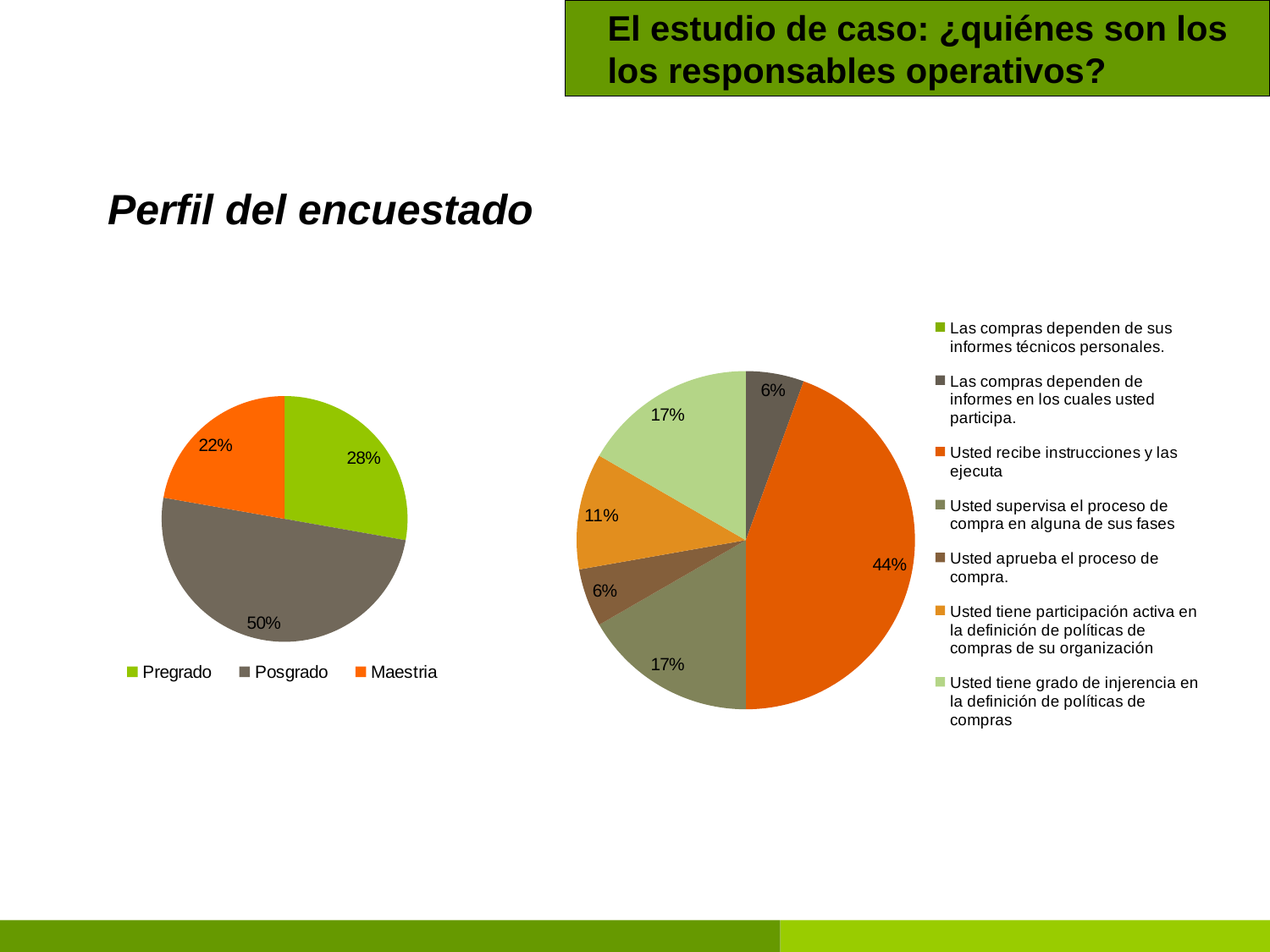
On the right pie chart, what share is labelled for 'Usted tiene participación activa en la definición de políticas de compras de su organización'? 11% On the left pie chart, what is the difference in percentage points between Posgrado and Pregrado? 22 On the left pie chart, which category has the smallest slice? Maestria On the left pie chart, which category has the largest slice? Posgrado How many entries does the legend of the right pie chart list? 7 On the left pie chart, which is larger, Pregrado or Maestria? Pregrado How many categories does the legend of the left pie chart list? 3 On the right pie chart, what share is labelled for 'Usted recibe instrucciones y las ejecuta'? 44% On the left pie chart, what share is labelled for Pregrado? 28% What kind of chart is the chart on the left of the slide? Pie chart On the left pie chart, what share is labelled for Maestria? 22% On the left pie chart, what share is labelled for Posgrado? 50%